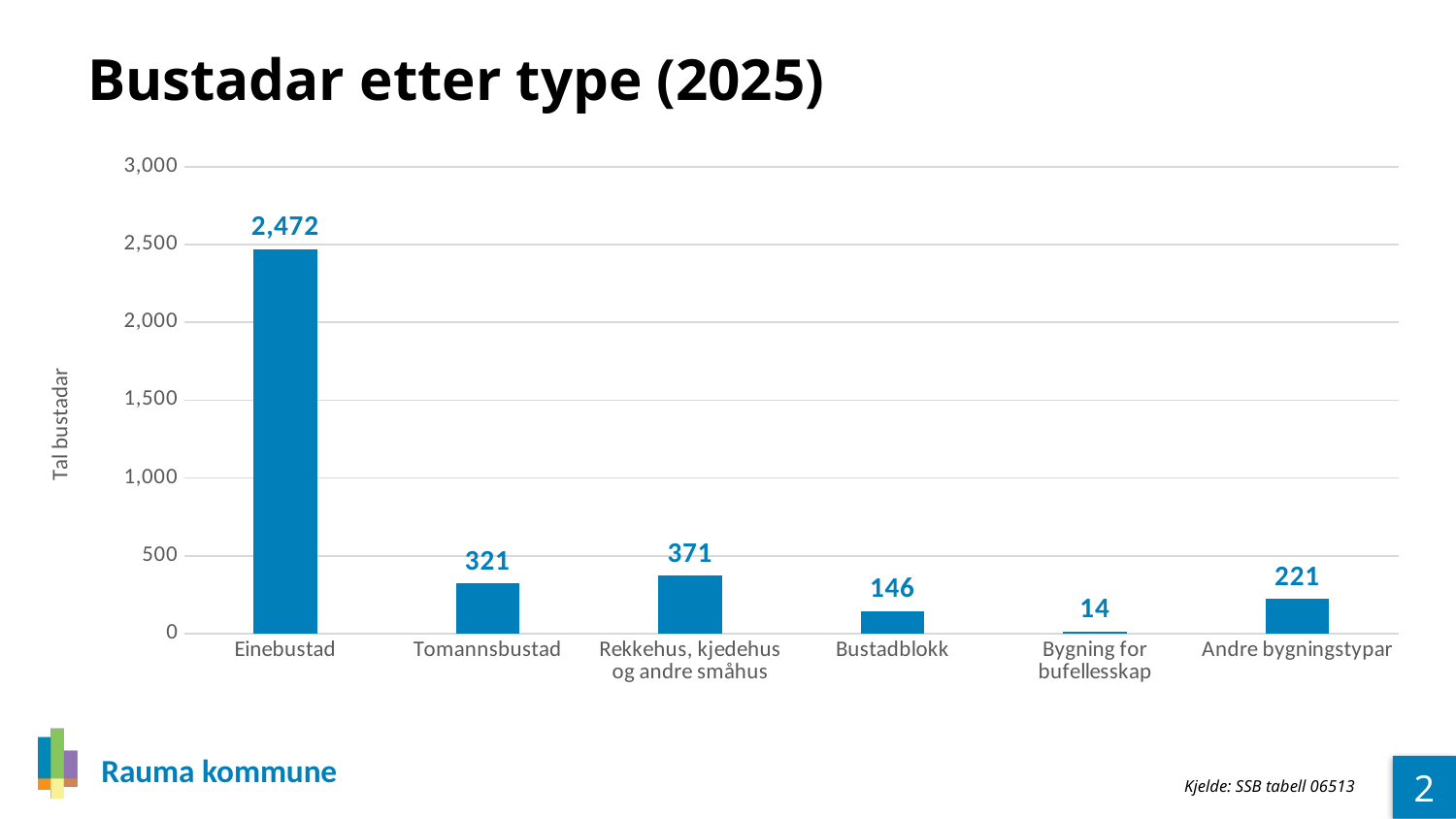
What is the value for Andre bygningstypar? 221 Is the value for Einebustad greater or less than 2,000? greater What is the title of the chart? Bustadar etter type (2025) What is the value for Einebustad? 2,472 Which is larger, the value for Bustadblokk or the value for Andre bygningstypar? Andre bygningstypar What is the difference between the values for Rekkehus, kjedehus og andre småhus and Tomannsbustad? 50 Which category has the highest value? Einebustad How many categories are shown on the x axis? 6 What is the value for Tomannsbustad? 321 Which category has the lowest value? Bygning for bufellesskap What kind of chart is this? Bar chart What is the value for Bygning for bufellesskap? 14